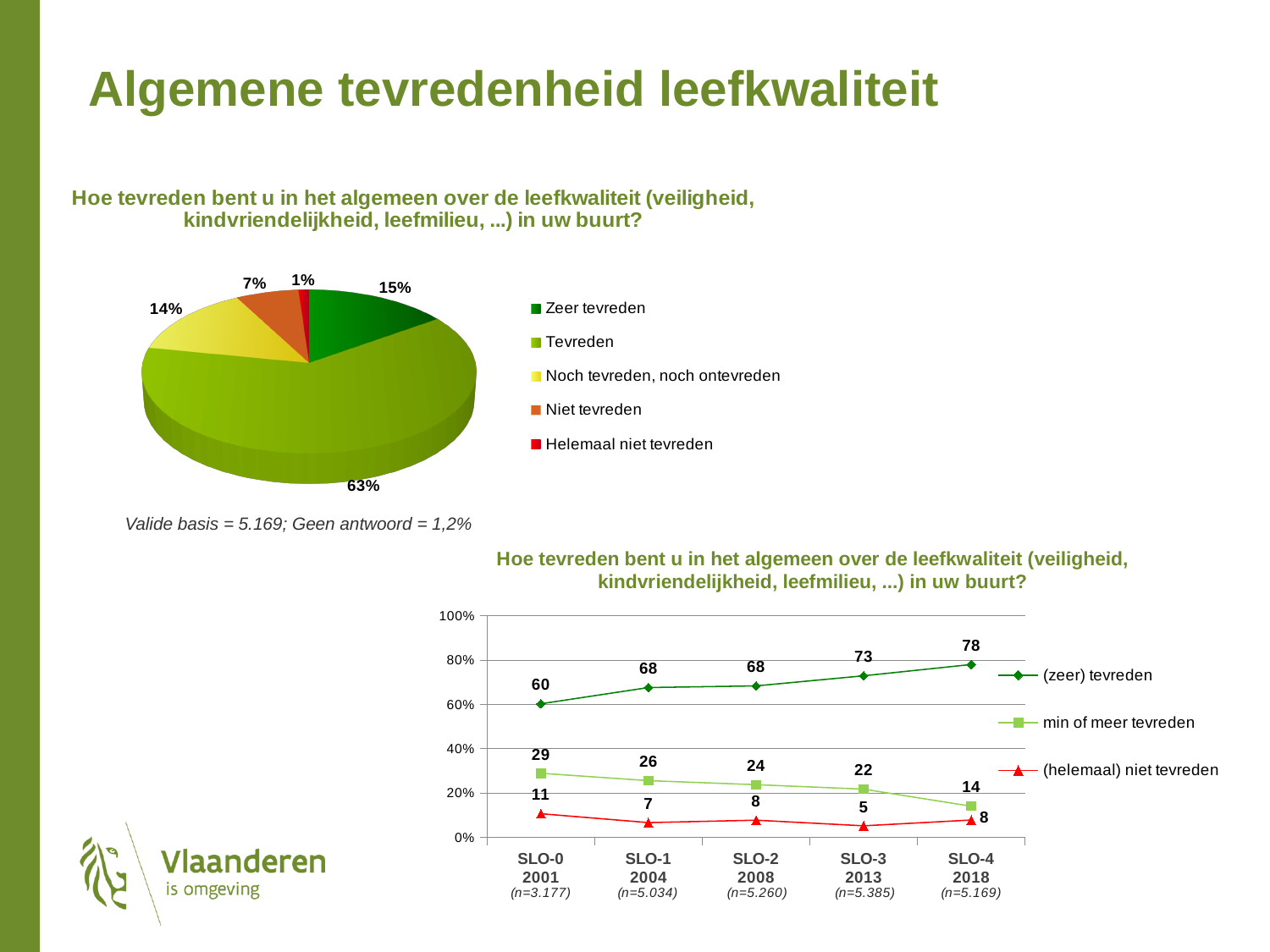
In the line chart at the bottom right, which survey wave has the lowest value for '(helemaal) niet tevreden'? SLO-3 2013 In the pie chart on the left, what is the difference between the 'Noch tevreden, noch ontevreden' share and the 'Niet tevreden' share? 7% In the line chart at the bottom right, what is the value for '(zeer) tevreden' at SLO-4 2018? 78 In the line chart at the bottom right, does the '(zeer) tevreden' series rise or fall from SLO-0 2001 to SLO-4 2018? Rise In the pie chart on the left, what share of respondents answered 'Tevreden'? 63% In the pie chart on the left, what share of respondents answered 'Zeer tevreden'? 15% What type of chart is shown at the bottom right of the slide? Line chart In the line chart at the bottom right, how many series does the legend list? 3 In the line chart at the bottom right, what is the value for 'min of meer tevreden' at SLO-0 2001? 29 In the pie chart on the left, which category has the smallest slice? Helemaal niet tevreden In the line chart at the bottom right, what is the difference between the '(zeer) tevreden' values at SLO-4 2018 and SLO-0 2001? 18 In the pie chart on the left, how many categories does the legend list? 5